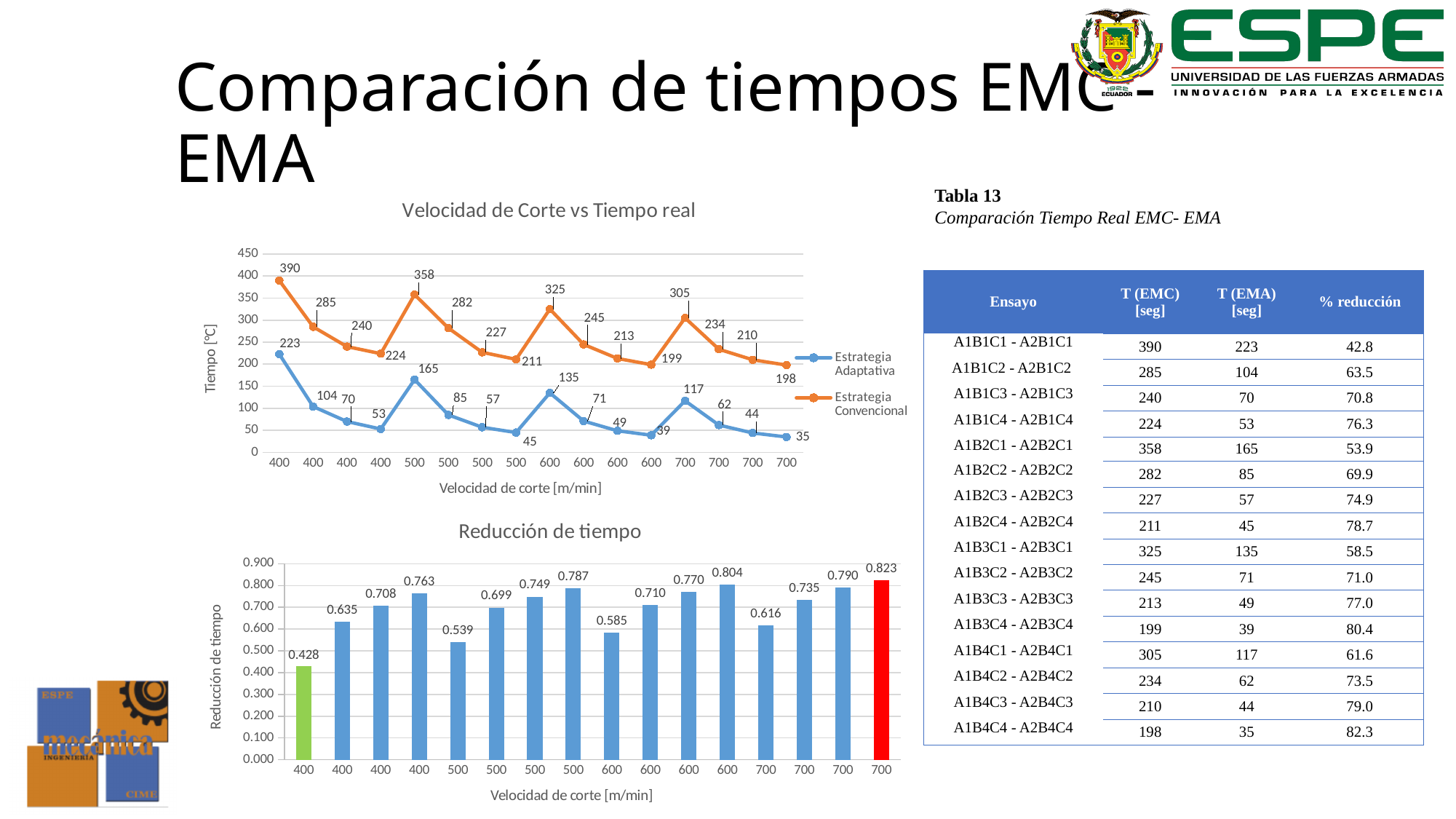
What type of chart is 'Velocidad de Corte vs Tiempo real'? Line chart In the 'Velocidad de Corte vs Tiempo real' chart, what is the value of the last point of the Estrategia Adaptativa series? 35 How many series does the legend of the 'Velocidad de Corte vs Tiempo real' chart list? 2 In the 'Velocidad de Corte vs Tiempo real' chart, what is the difference between the first points of the Estrategia Convencional (390) and Estrategia Adaptativa (223) series? 167 In the 'Reducción de tiempo' chart, what is the value of the tallest bar? 0.823 How many bars are plotted in the 'Reducción de tiempo' chart? 16 In the 'Velocidad de Corte vs Tiempo real' chart, what is the highest value of the Estrategia Adaptativa series? 223 In the 'Velocidad de Corte vs Tiempo real' chart, what is the lowest value of the Estrategia Convencional series? 198 In the 'Velocidad de Corte vs Tiempo real' chart, what is the value of the first point of the Estrategia Convencional series? 390 In the 'Reducción de tiempo' chart, what is the value of the shortest bar? 0.428 In the 'Reducción de tiempo' chart, what colour is the tallest bar? Red What type of chart is 'Reducción de tiempo'? Bar chart